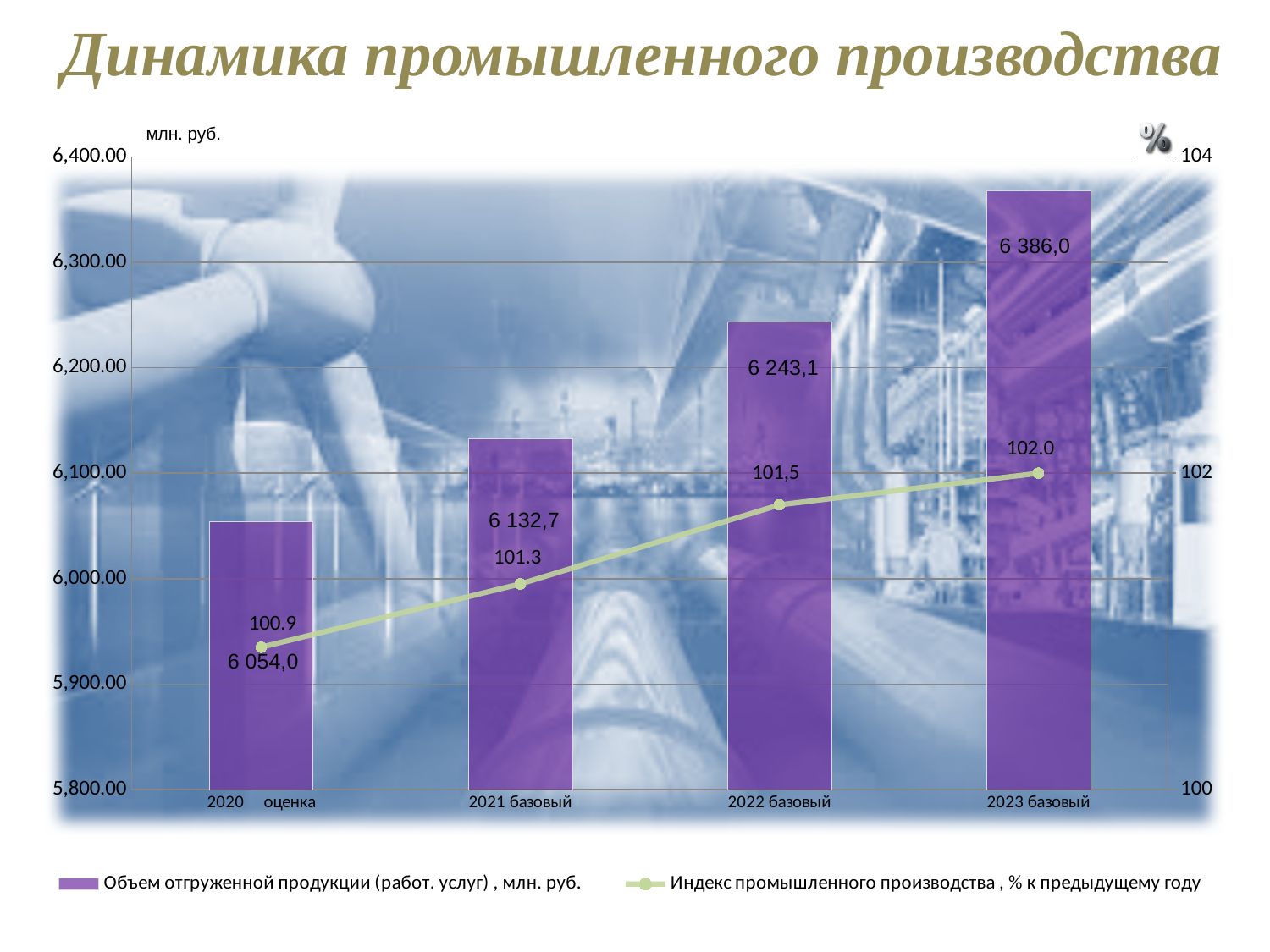
What is the difference between the Объем отгруженной продукции values for 2023 базовый and 2022 базовый? 142,9 What is the value of Объем отгруженной продукции for 2022 базовый? 6 243,1 What is the value of Индекс промышленного производства for 2021 базовый? 101.3 How many years are shown on the x axis? 4 Is the Объем отгруженной продукции for 2021 базовый greater or less than 6,100.00? greater Which year has the lowest value of Индекс промышленного производства? 2020 оценка What is the value of Объем отгруженной продукции for 2020 оценка? 6 054,0 Does the Индекс промышленного производства rise or fall from 2020 to 2023? rise How many series does the legend list? 2 Which year has the highest value of Объем отгруженной продукции? 2023 базовый Which is larger: the Объем отгруженной продукции for 2021 базовый or for 2022 базовый? 2022 базовый What is the title of the slide? Динамика промышленного производства